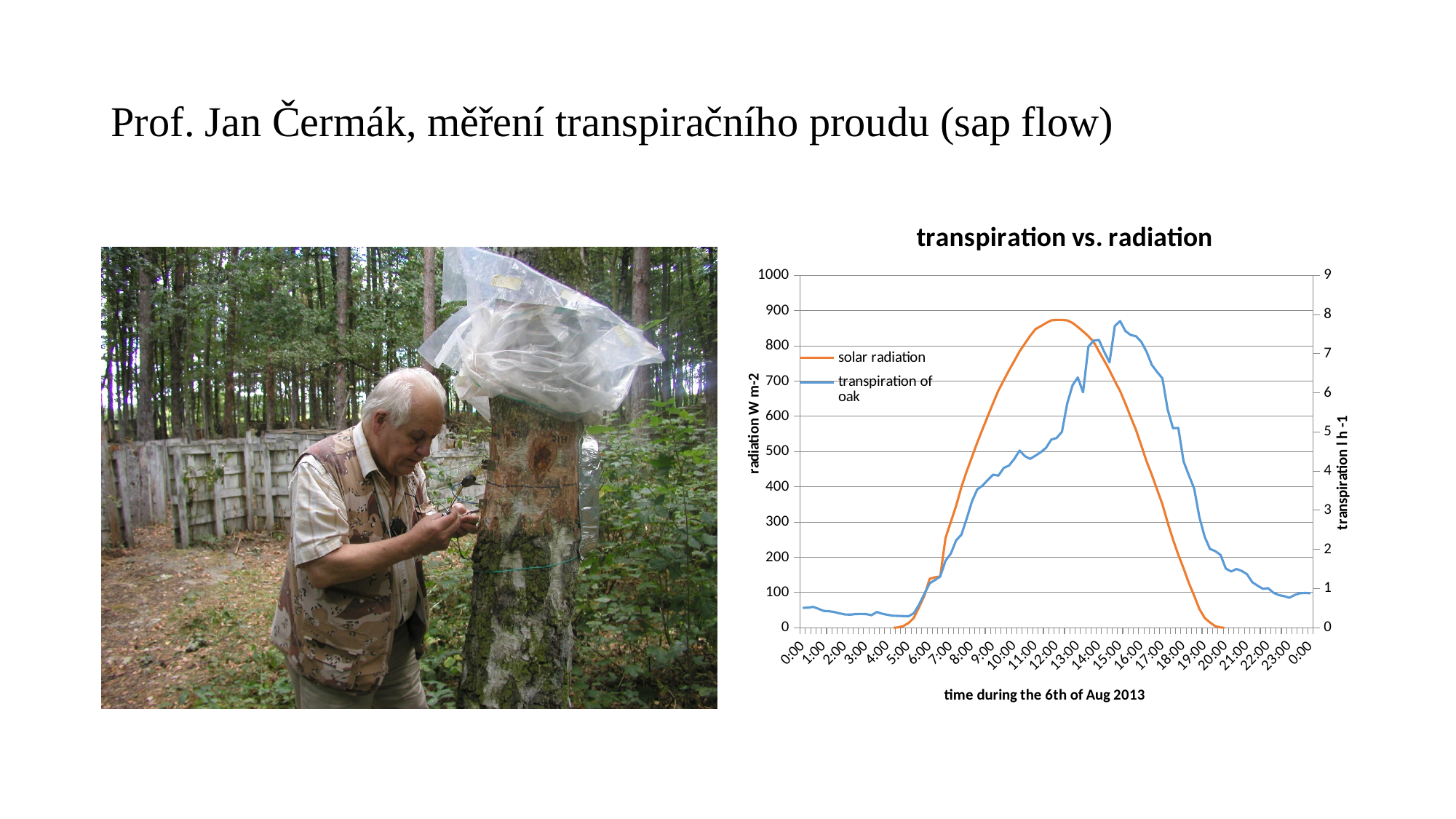
Is the solar radiation value at 18:00 greater or less than 300? less Does the transpiration of oak line rise or fall between 16:00 and 21:00? fall Is the transpiration of oak value at 3:00 greater or less than 1? less How many time labels are shown along the x axis of the chart? 25 What colour is the solar radiation line in the chart? orange Is the transpiration of oak value at 15:00 greater or less than 7? greater How many series does the legend of the chart list? 2 What is the title of the chart? transpiration vs. radiation What kind of chart is shown on the slide? line chart Does the solar radiation line rise or fall between 6:00 and 12:00? rise